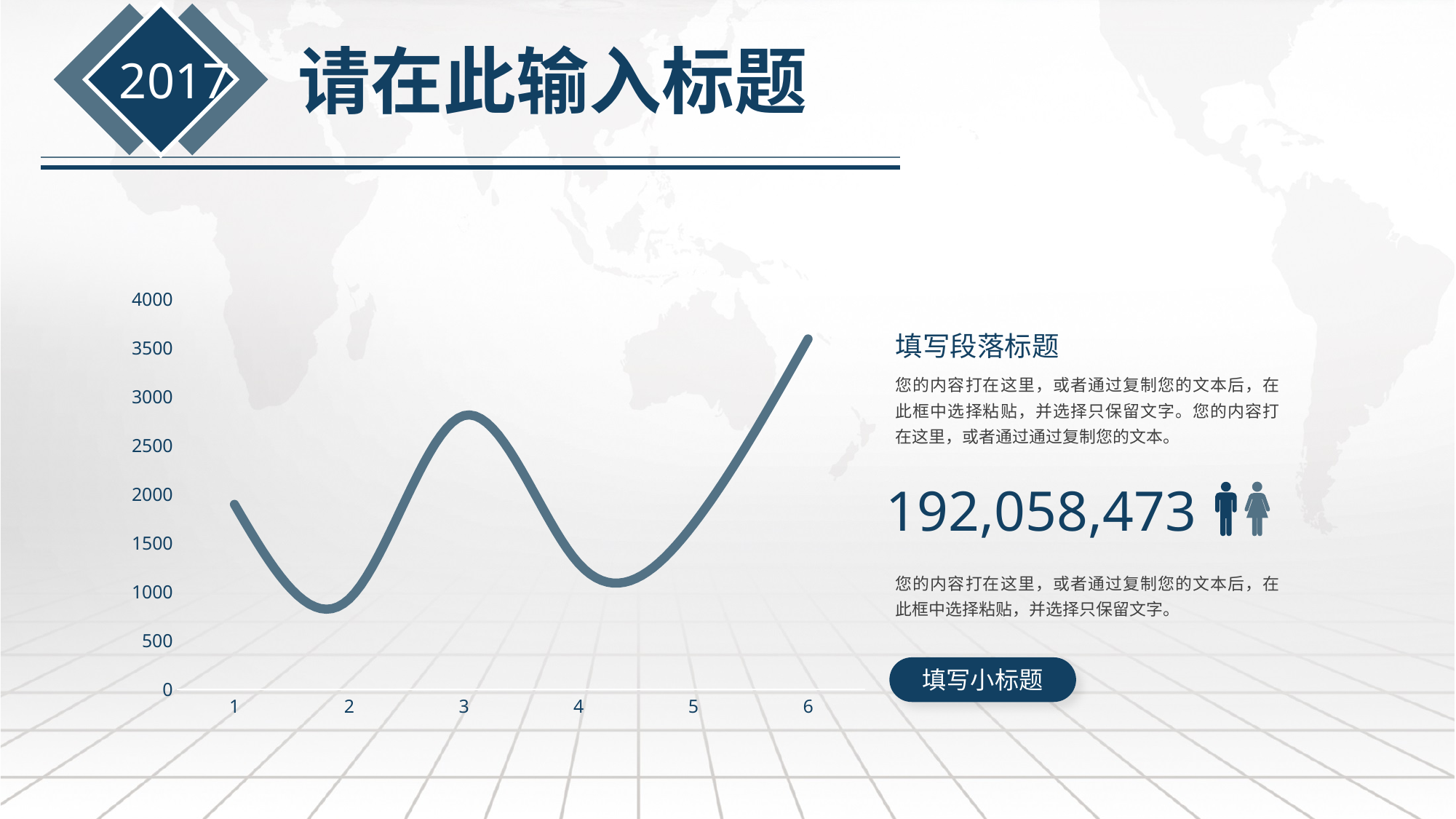
Which has the larger value, x = 3 or x = 6? 6 At which x-axis category does the line reach its highest value? 6 Is the value at x = 6 greater or less than 3000? greater Is the value at x = 4 greater or less than 2000? less Which has the larger value, x = 1 or x = 2? 1 At which x-axis category does the line reach its lowest value? 2 What kind of chart is shown on the slide? line chart Is the value at x = 3 greater or less than 2500? greater What is the highest value shown on the y-axis? 4000 How many points are plotted on the line chart? 6 Does the line rise or fall between x = 3 and x = 4? fall